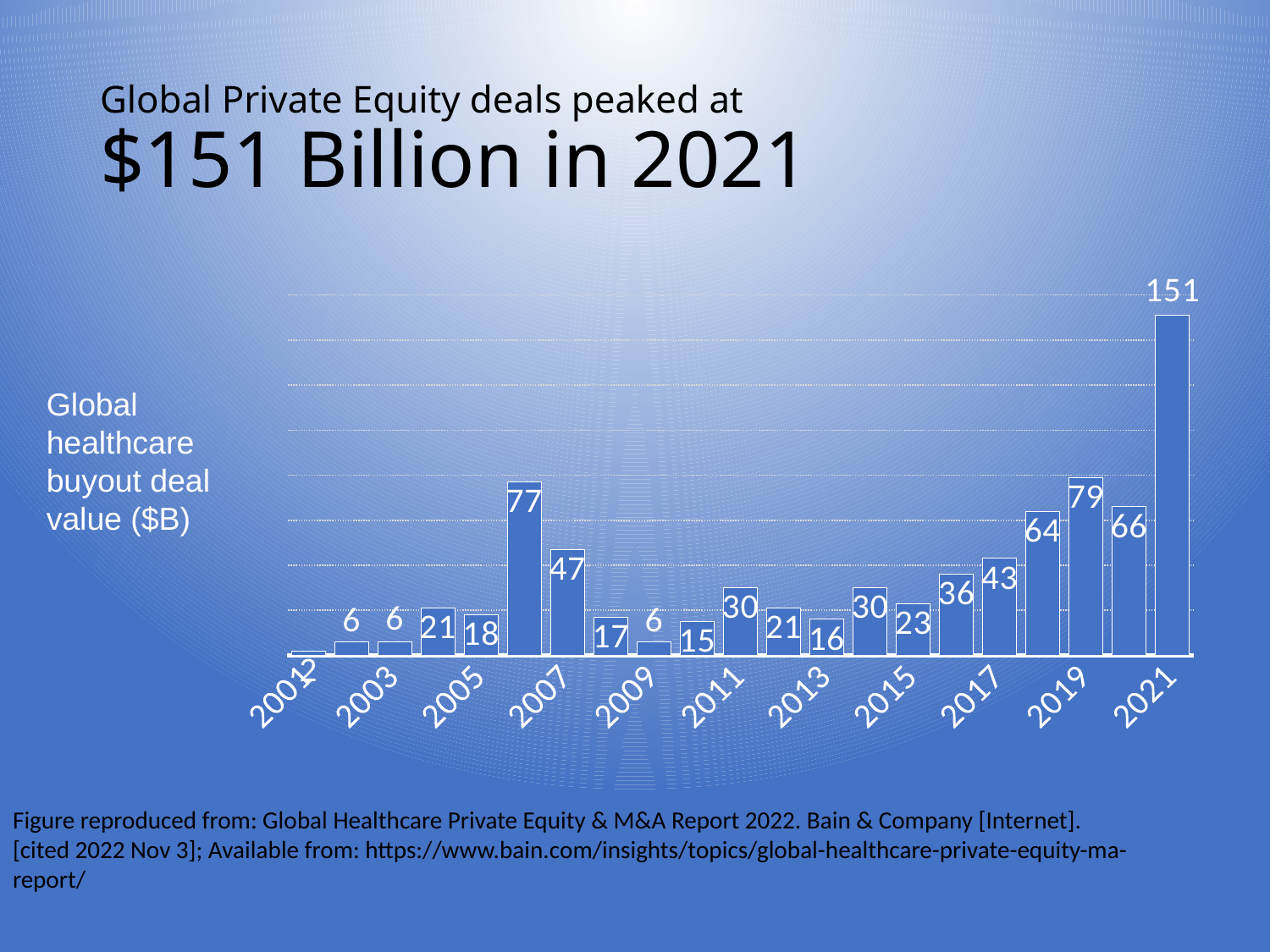
What is the difference between the deal values for 2021 and 2019? 72 What is the global healthcare buyout deal value for 2021? 151 Which year has the lowest global healthcare buyout deal value? 2001 What is the global healthcare buyout deal value for 2017? 43 What is the global healthcare buyout deal value for 2019? 79 Do the deal values generally rise or fall from 2013 to 2021? Rise How many bars (years) are plotted in the chart? 21 What is the global healthcare buyout deal value for 2007? 47 Which year has the highest global healthcare buyout deal value? 2021 Which year has a larger deal value, 2007 or 2017? 2007 What kind of chart is shown on the slide? Bar chart What is the global healthcare buyout deal value for 2013? 16